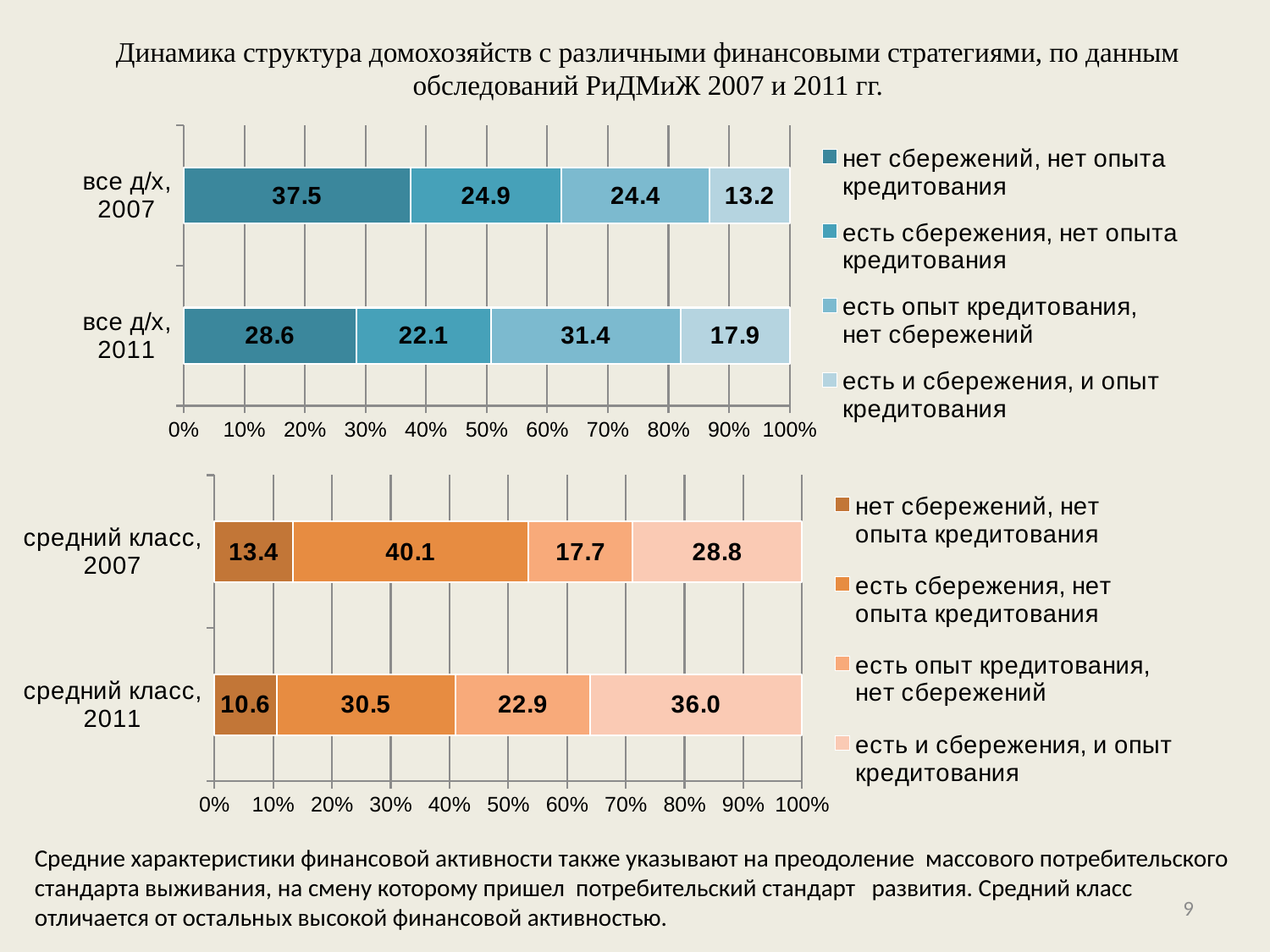
How many bars (categories) are shown in the bottom chart? 2 How many series does the legend of the top chart list? 4 In the bottom chart, what is the value for 'есть и сбережения, и опыт кредитования' for 'средний класс, 2011'? 36.0 In the top chart, what is the value for 'нет сбережений, нет опыта кредитования' for 'все д/х, 2007'? 37.5 In the top chart, what is the difference between the 'нет сбережений, нет опыта кредитования' values for 2007 and 2011? 8.9 In the top chart, what is the value for 'есть опыт кредитования, нет сбережений' for 'все д/х, 2011'? 31.4 In the bottom chart, what is the value for 'есть сбережения, нет опыта кредитования' for 'средний класс, 2007'? 40.1 In the bottom chart, which segment is the smallest in the 'средний класс, 2011' bar? нет сбережений, нет опыта кредитования In the bottom chart, what is the difference between the 'есть и сбережения, и опыт кредитования' values for 2011 and 2007? 7.2 What kind of chart is the top chart? Stacked bar chart In the top chart, which segment is the largest in the 'все д/х, 2007' bar? нет сбережений, нет опыта кредитования In the bottom chart, which is larger for 'средний класс, 2011': 'есть сбережения, нет опыта кредитования' or 'есть и сбережения, и опыт кредитования'? есть и сбережения, и опыт кредитования